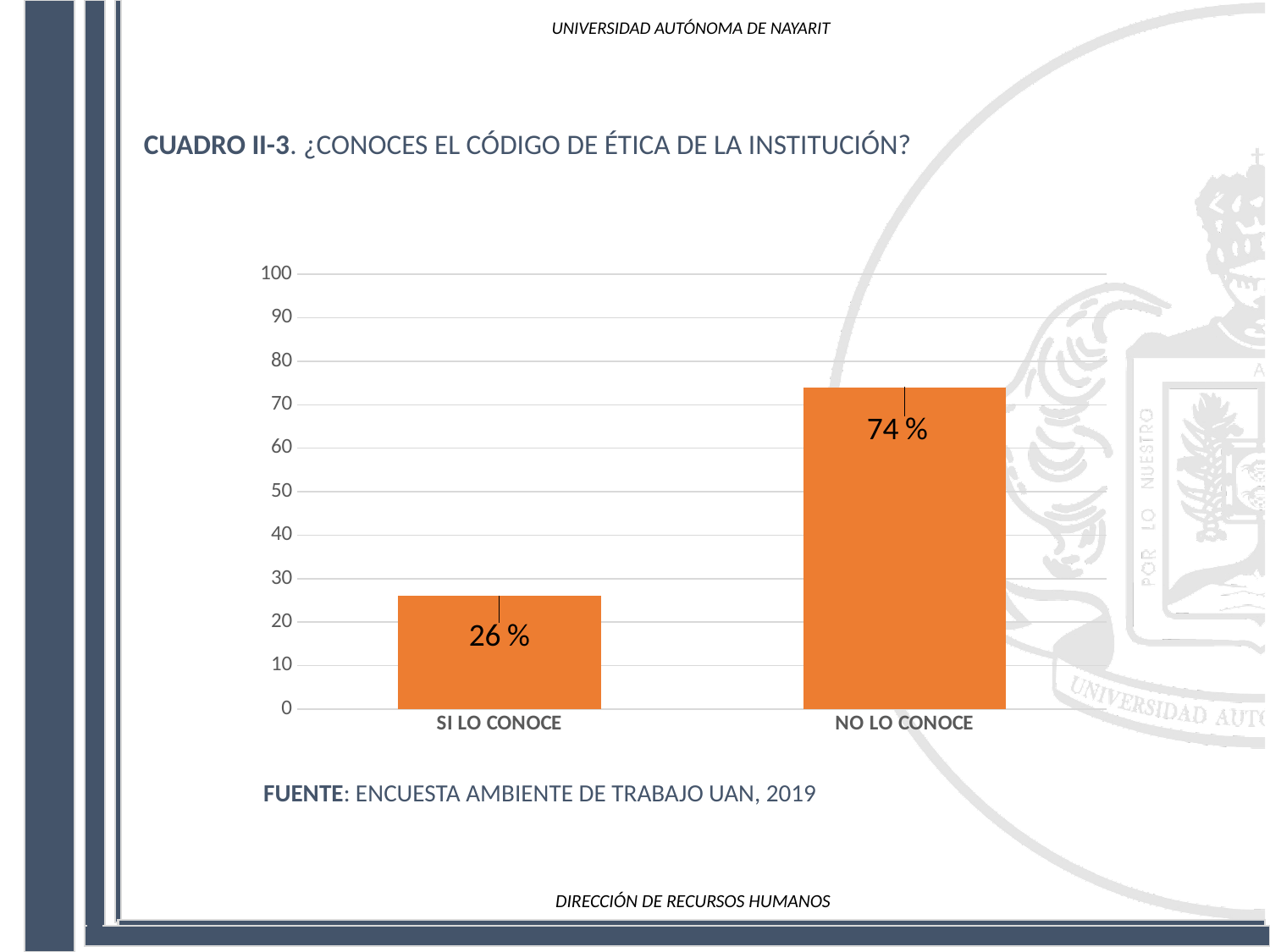
Which category has the lowest value? SI LO CONOCE What is the value for SI LO CONOCE? 26 % Which is larger, the value for SI LO CONOCE or the value for NO LO CONOCE? NO LO CONOCE What is the value for NO LO CONOCE? 74 % How many categories are shown on the chart? 2 What is the difference between the values for NO LO CONOCE and SI LO CONOCE? 48 % Is the value for SI LO CONOCE greater or less than 30? less What is the title of the chart? CUADRO II-3. ¿CONOCES EL CÓDIGO DE ÉTICA DE LA INSTITUCIÓN? What is the source cited below the chart? ENCUESTA AMBIENTE DE TRABAJO UAN, 2019 What kind of chart is shown on the slide? bar chart Is the value for NO LO CONOCE greater or less than 50? greater Which category has the highest value? NO LO CONOCE